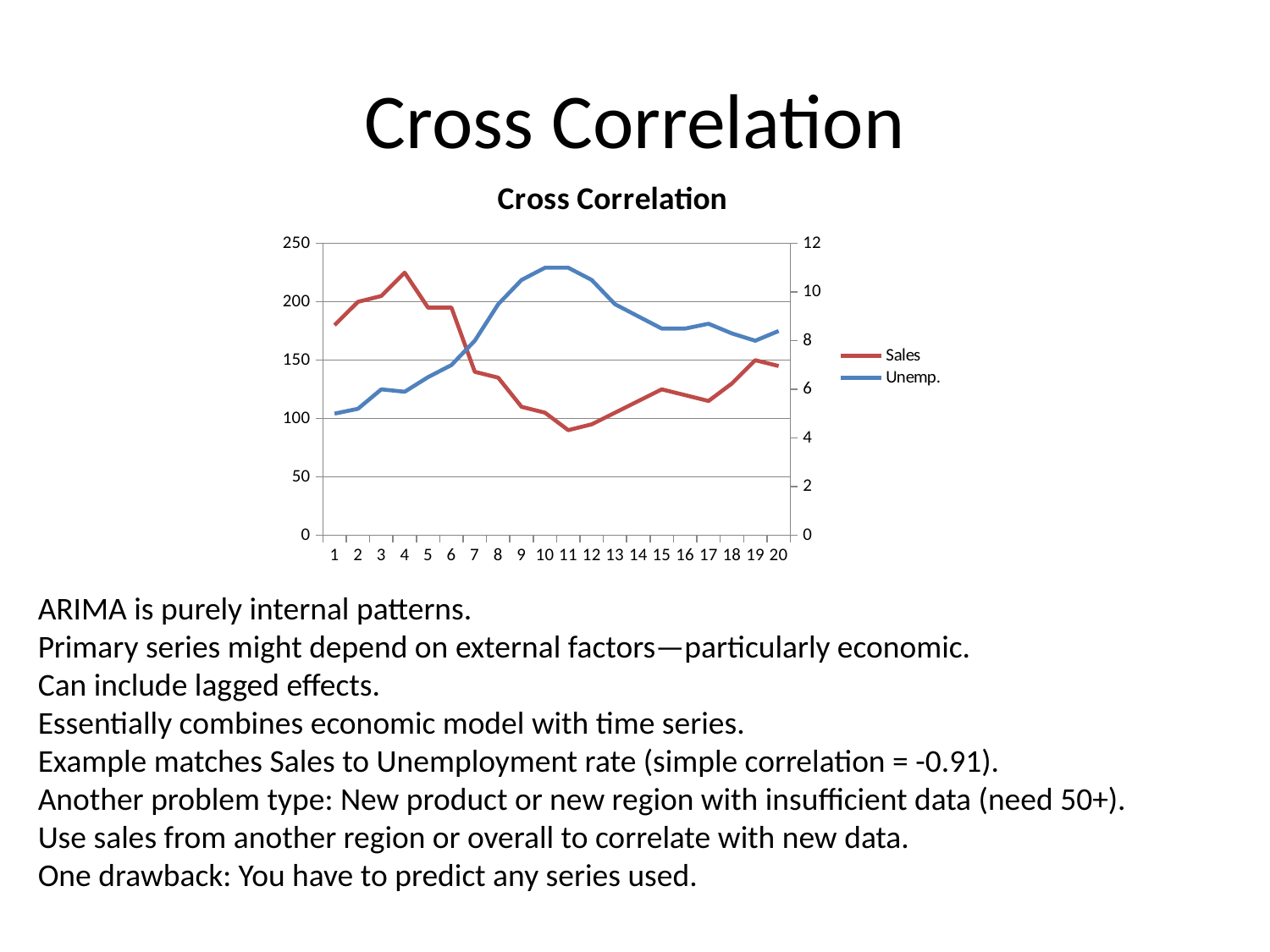
Does the Sales series rise or fall from point 4 to point 11? fall How many points are plotted along the x axis for each series? 20 How many series does the legend list? 2 Is the Unemp. value at point 1 greater or less than 6? less Is the Sales value at point 4 greater or less than 200? greater Is the Unemp. value at point 10 greater or less than 10? greater What kind of chart is shown on the slide? line chart At which x-axis point does the Sales series reach its lowest value? 11 Does the Unemp. series rise or fall from point 1 to point 10? rise At which x-axis point does the Sales series reach its highest value? 4 What colour is the Sales line in the chart? red